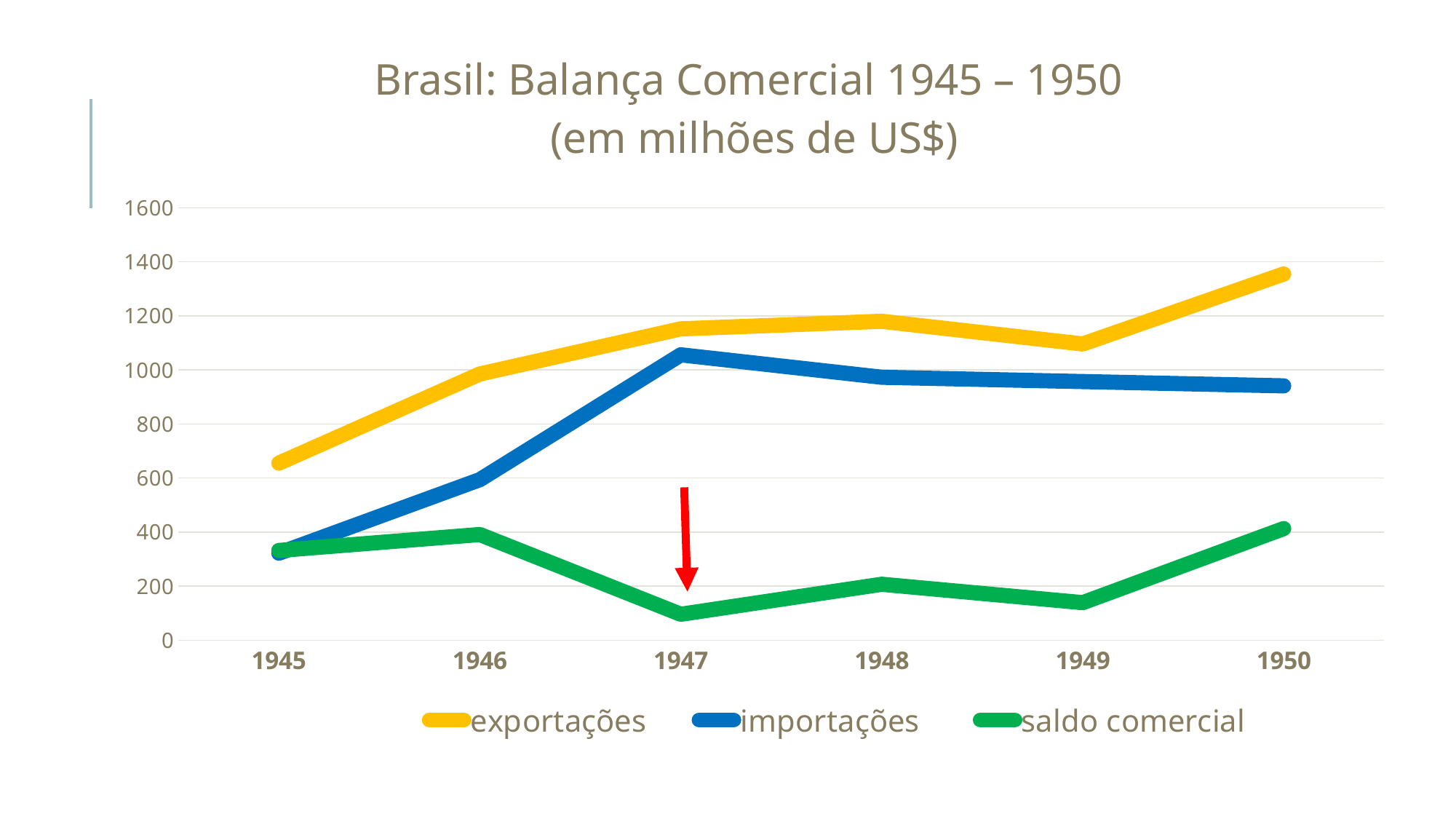
In which year is the saldo comercial at its lowest? 1947 Is the value of exportações in 1950 greater or less than 1200? greater Do importações rise or fall between 1945 and 1947? rise Which is larger in 1946, exportações or importações? exportações How many years are plotted along the x axis? 6 What kind of chart is shown on the slide? line chart In which year do exportações reach their highest value? 1950 Is the value of saldo comercial in 1947 greater or less than 200? less Is the value of importações in 1945 greater or less than 400? less Which series does the red arrow point to? saldo comercial In which year do importações reach their highest value? 1947 How many series does the legend list? 3